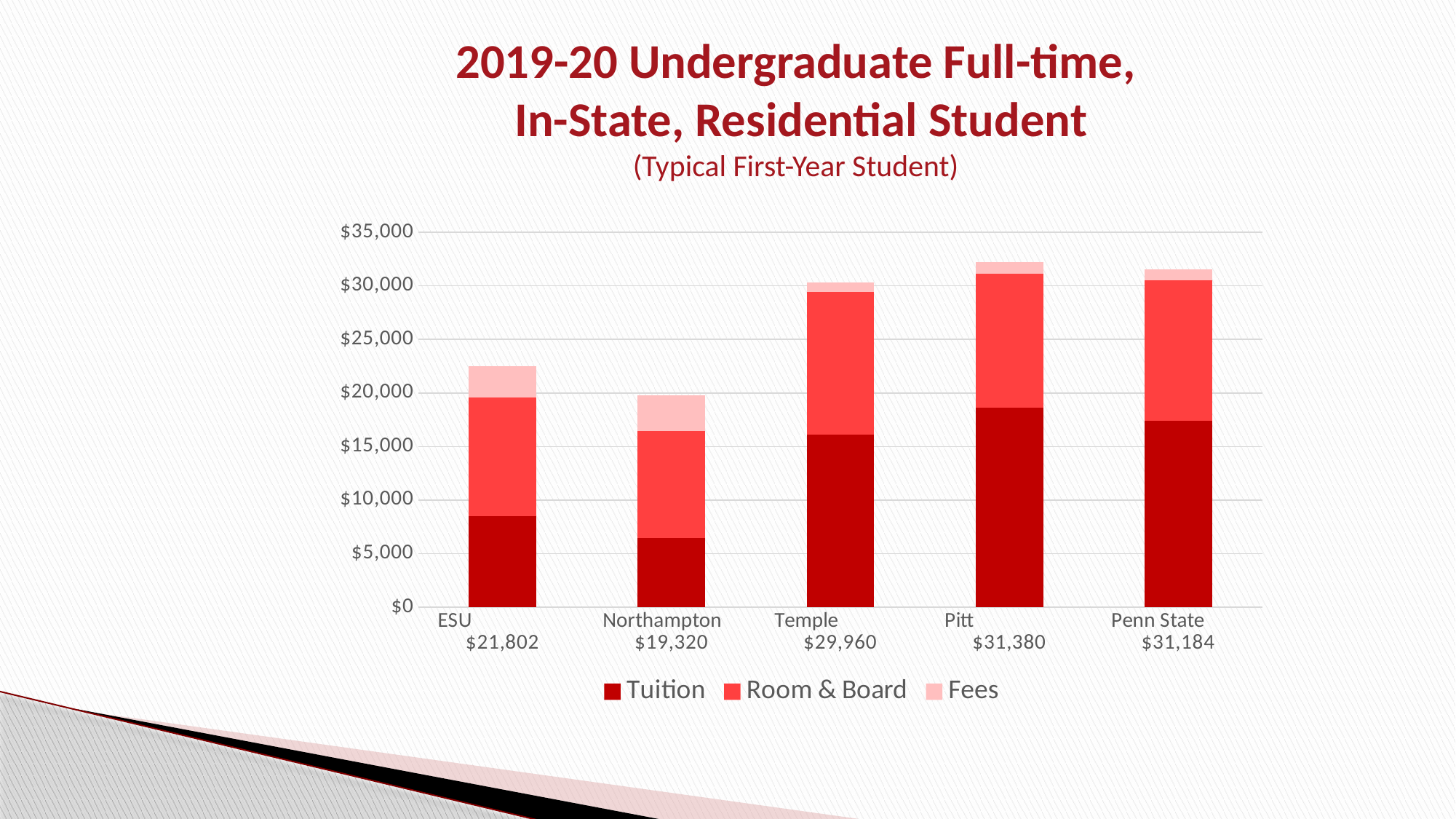
What is the total cost shown for ESU? $21,802 What is the difference between the total cost for ESU and the total cost for Northampton? $2,482 What kind of chart is shown on the slide? Stacked bar chart Which has a larger total cost, Temple or Penn State? Penn State Which institution has the lowest total cost? Northampton What is the difference between the total cost for Pitt and the total cost for Penn State? $196 Is the Tuition value for Pitt greater or less than $15,000? greater What is the total cost shown for Temple? $29,960 How many institutions are shown on the chart? 5 Is the Tuition value for ESU greater or less than $10,000? less Which institution has the highest total cost? Pitt How many series does the legend list? 3